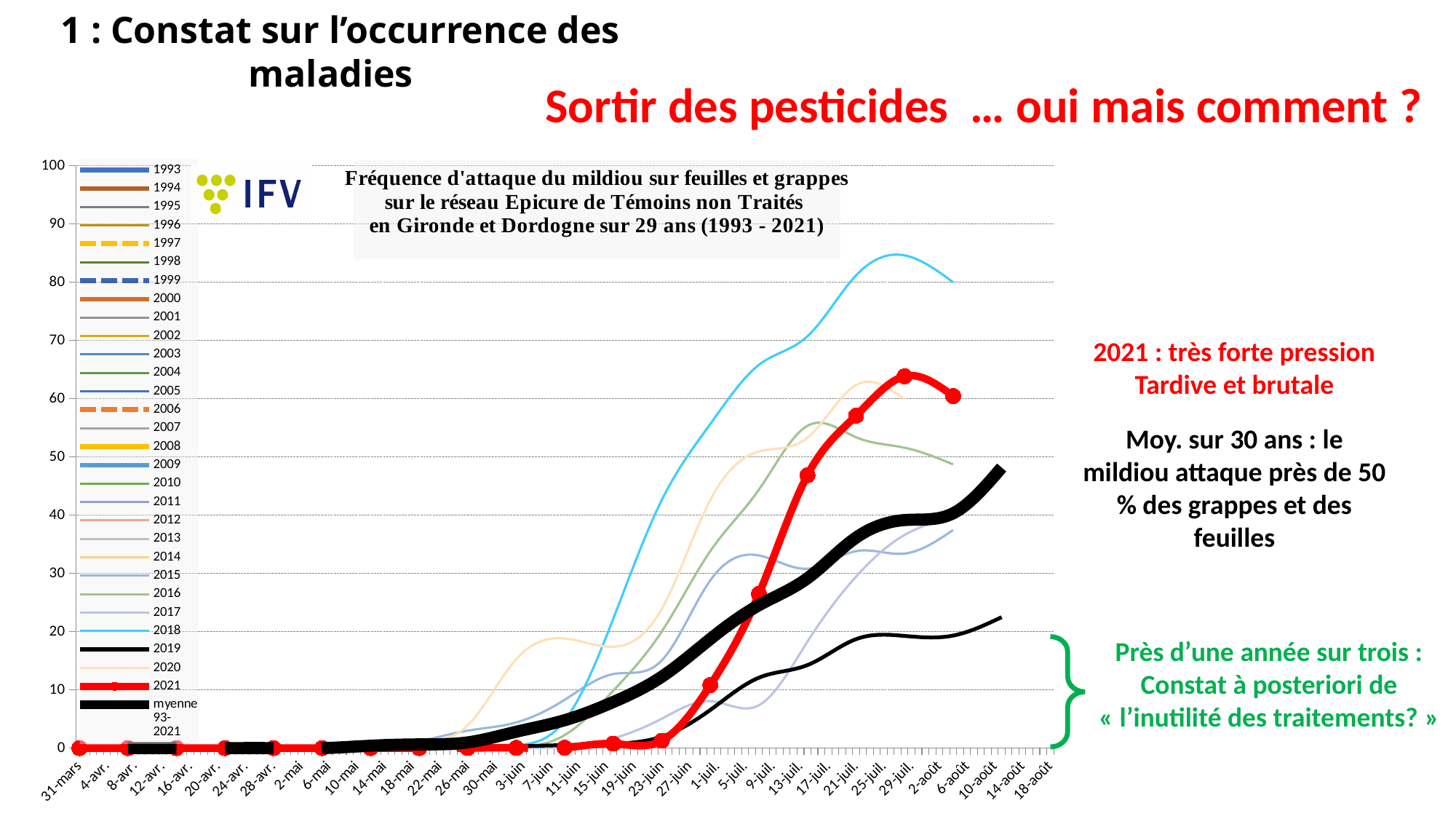
Is the peak value of the 2021 series greater or less than 60? greater Which year's series reaches the highest value on the chart? 2018 Which reaches a higher peak value, the 2018 series or the 2021 series? 2018 What kind of chart is shown on the slide? line chart Is the value of the 2021 series at 13-juil. greater or less than 50? less How many series does the chart legend list? 30 Is the peak value of the 2018 series greater or less than 80? greater What colour is the 2021 series drawn in? red What is the first line of the chart's title? Fréquence d'attaque du mildiou sur feuilles et grappes Does the 2021 series rise or fall between 23-juin and 29-juil.? rise